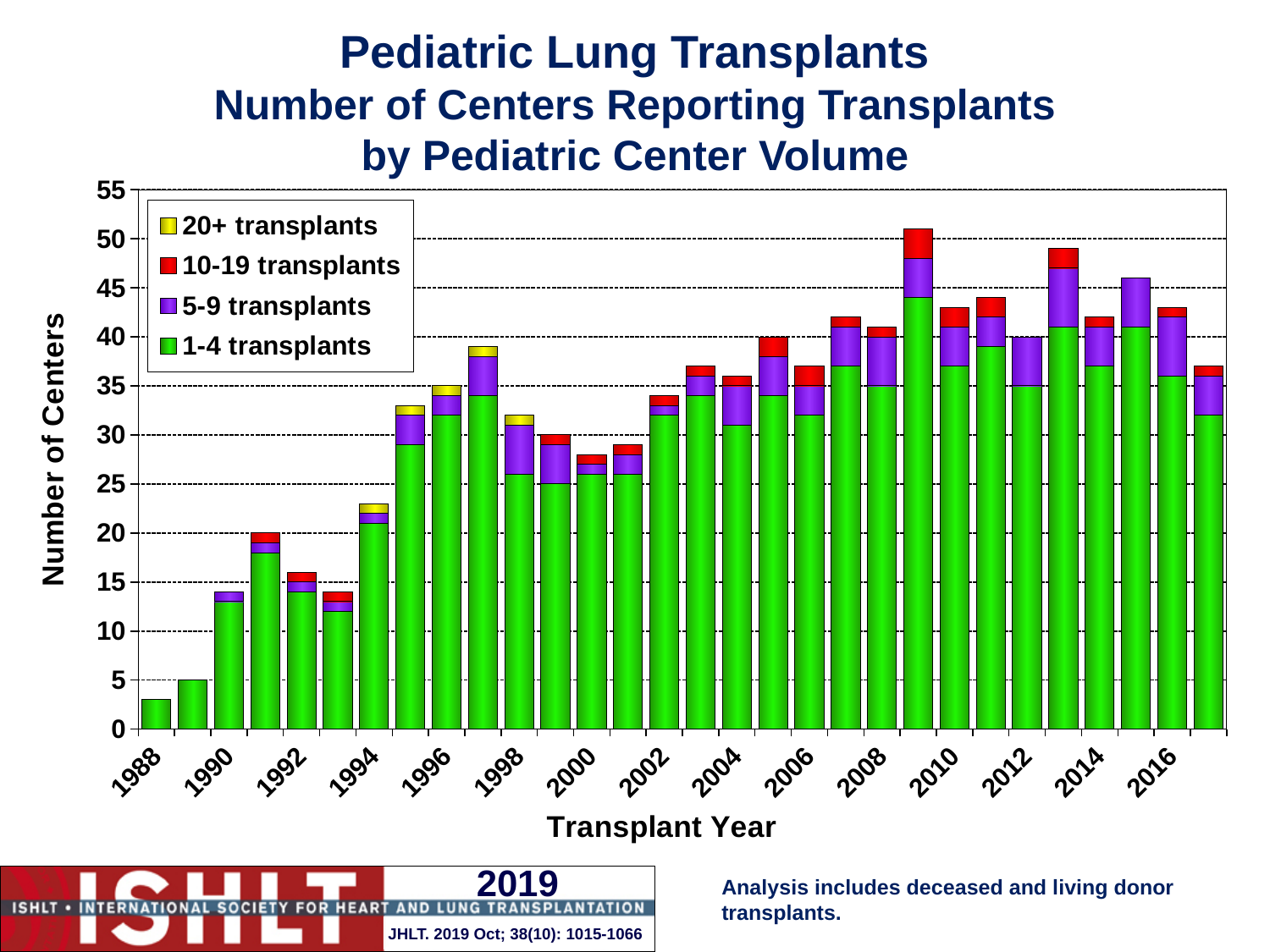
Is the total number of centers for 1988 greater or less than 5? less Is the total number of centers for 2009 greater or less than 50? greater How many transplant years are plotted on the x axis? 30 What kind of chart is shown on the slide? Stacked bar chart Which transplant year has the lowest total number of centers? 1988 Which transplant year has the highest total number of centers? 2009 Which year has a larger total number of centers, 1994 or 1995? 1995 Is the total number of centers for 1995 greater or less than 30? greater Which colour represents the '1-4 transplants' series in the legend? Green How many series does the legend list? 4 Do the total numbers of centers generally rise or fall from 1988 to 1997? rise